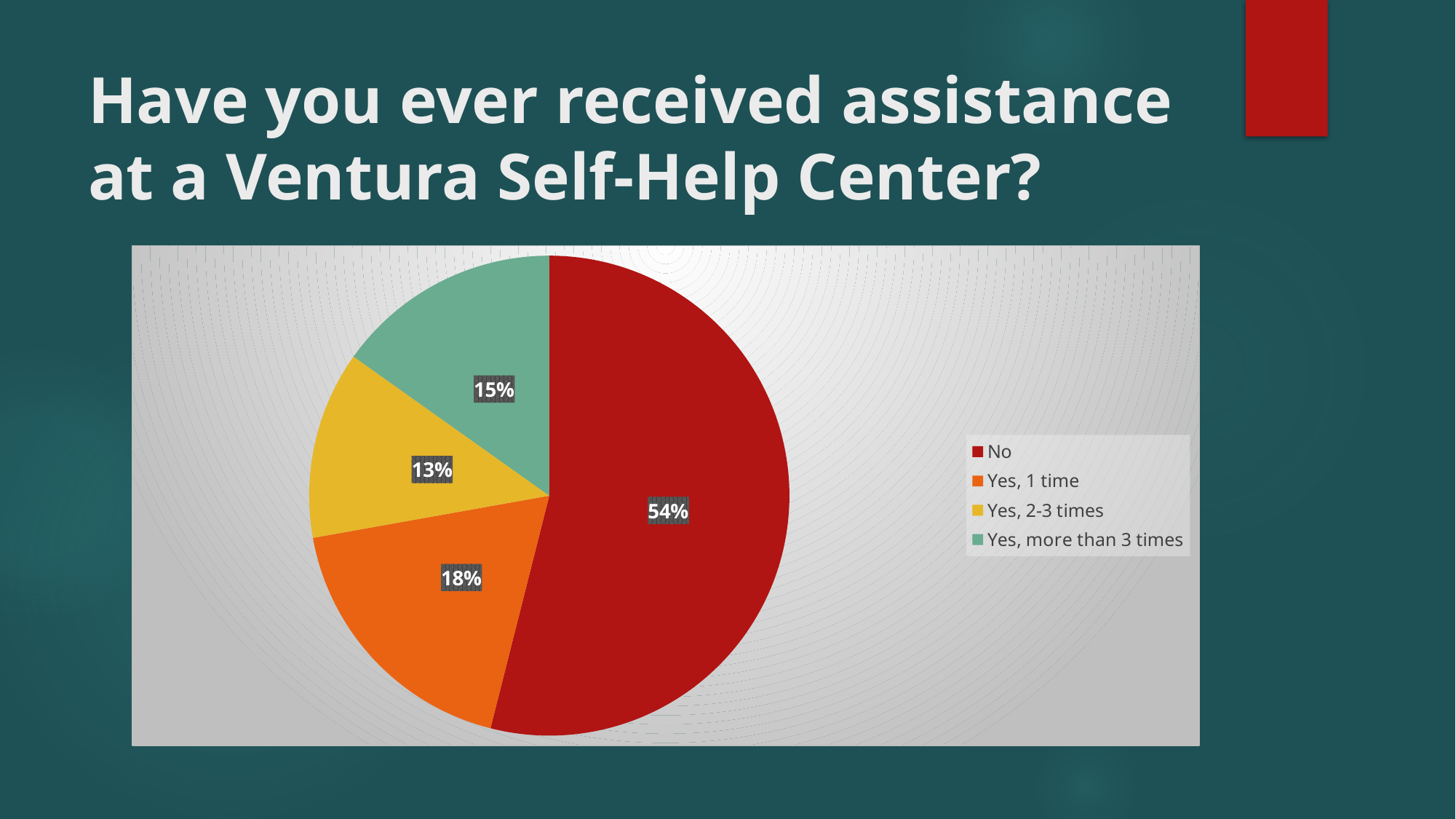
How many slices does the pie chart have? 4 Which response has the smallest share of the pie? Yes, 2-3 times Which is larger: the share for "Yes, more than 3 times" or the share for "Yes, 2-3 times"? Yes, more than 3 times What percentage of respondents answered "Yes, 1 time"? 18% What percentage of respondents answered "Yes, 2-3 times"? 13% What kind of chart is shown on the slide? pie chart What is the difference in percentage points between "No" and "Yes, 1 time"? 36 Which response has the largest share of the pie? No What percentage of respondents answered "No"? 54% What colour is the slice for "No"? red What percentage of respondents answered "Yes, more than 3 times"? 15% How many entries does the legend list? 4